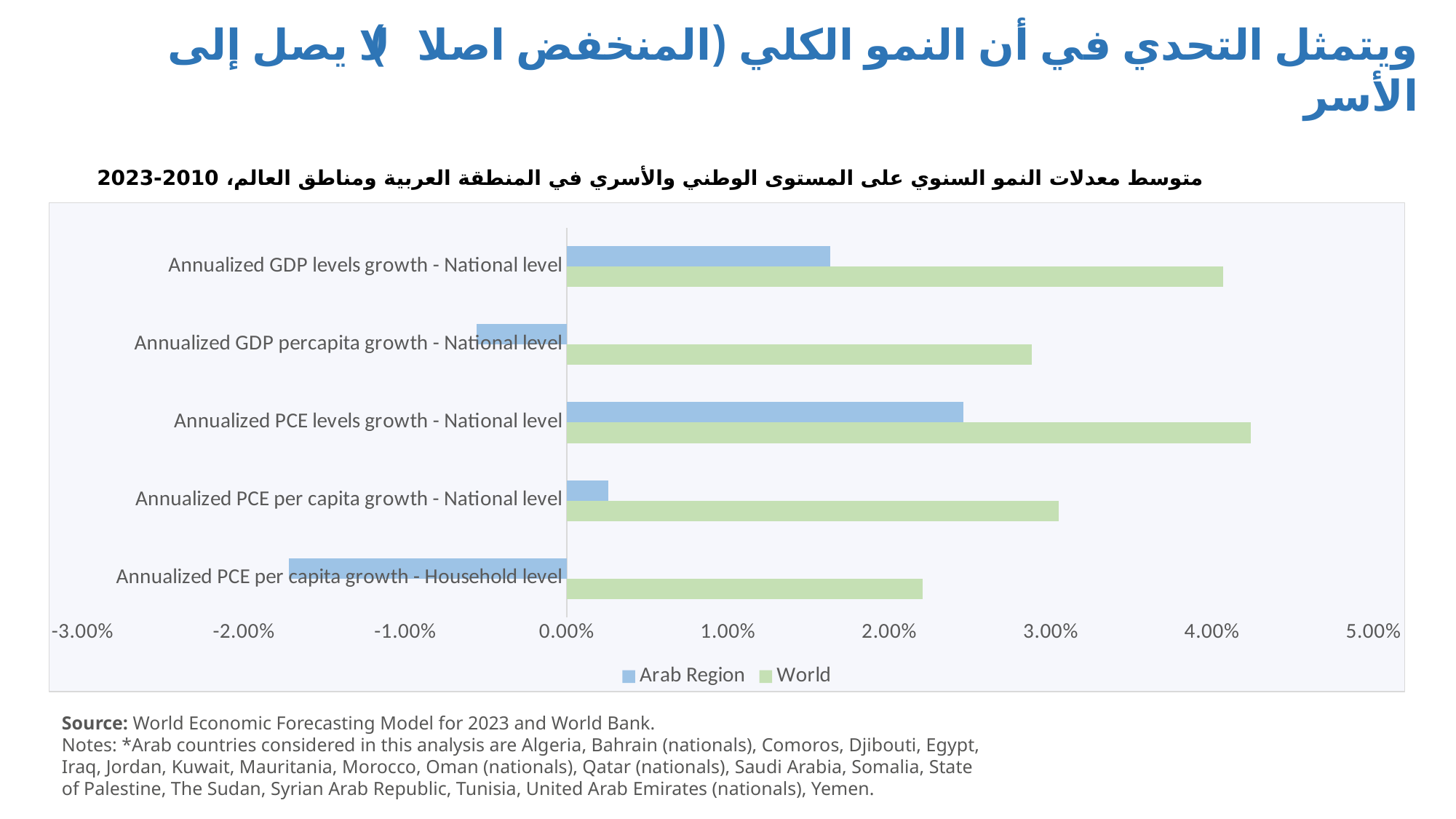
Which category has the lowest value for the World series? Annualized PCE per capita growth - Household level How many series does the legend list? 2 Is the Arab Region value for Annualized GDP levels growth - National level greater or less than 2.00%? less How many categories are plotted on the chart? 5 Is the World value for Annualized PCE levels growth - National level greater or less than 4.00%? greater Which category has the highest value for the Arab Region series? Annualized PCE levels growth - National level Is the Arab Region value for Annualized PCE per capita growth - Household level greater or less than -1.00%? less For Annualized GDP percapita growth - National level, which series has the larger value, Arab Region or World? World What kind of chart is shown on the slide? bar chart Which category has the lowest value for the Arab Region series? Annualized PCE per capita growth - Household level For Annualized PCE per capita growth - National level, which series has the larger value, Arab Region or World? World What are the two entries listed in the chart legend? Arab Region and World